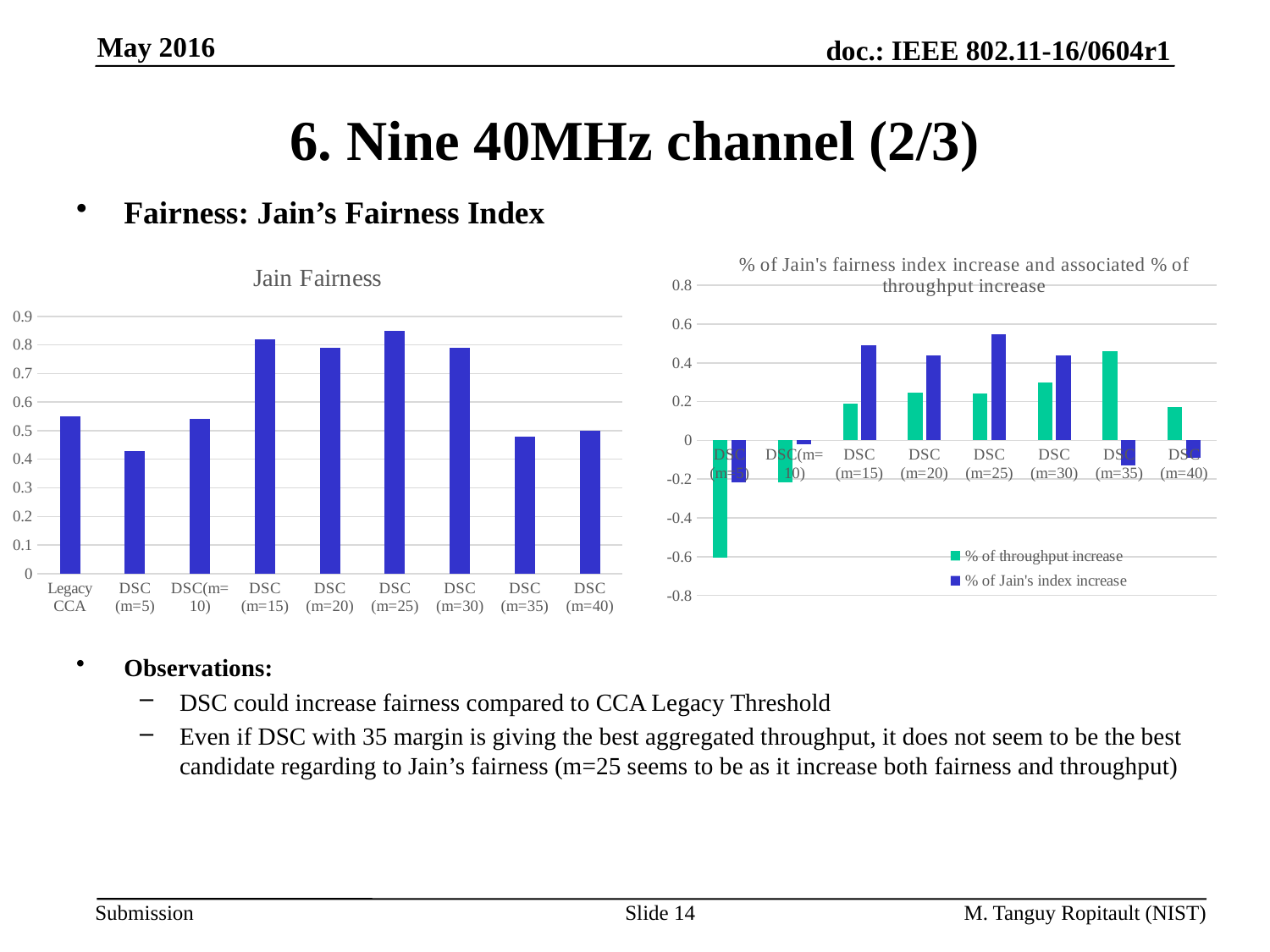
In the "Jain Fairness" chart, how many categories are shown on the x axis? 9 In the "Jain Fairness" chart, which category has the lowest value? DSC (m=5) In the chart on the right, how many categories are shown on the x axis? 8 In the chart on the right, is the "% of throughput increase" value for DSC (m=5) greater or less than -0.4? less What kind of chart is the "Jain Fairness" chart on the left? bar chart In the chart on the right, which category has the highest "% of Jain's index increase" value? DSC (m=25) How many series does the legend list in the chart on the right, "% of Jain's fairness index increase and associated % of throughput increase"? 2 In the "Jain Fairness" chart, is the value for Legacy CCA greater or less than 0.6? less In the chart on the right, which series is shown in green? % of throughput increase In the "Jain Fairness" chart, which is larger: the value for DSC (m=20) or the value for DSC (m=35)? DSC (m=20) In the "Jain Fairness" chart, is the value for DSC (m=15) greater or less than 0.7? greater In the "Jain Fairness" chart, which category has the highest value? DSC (m=25)